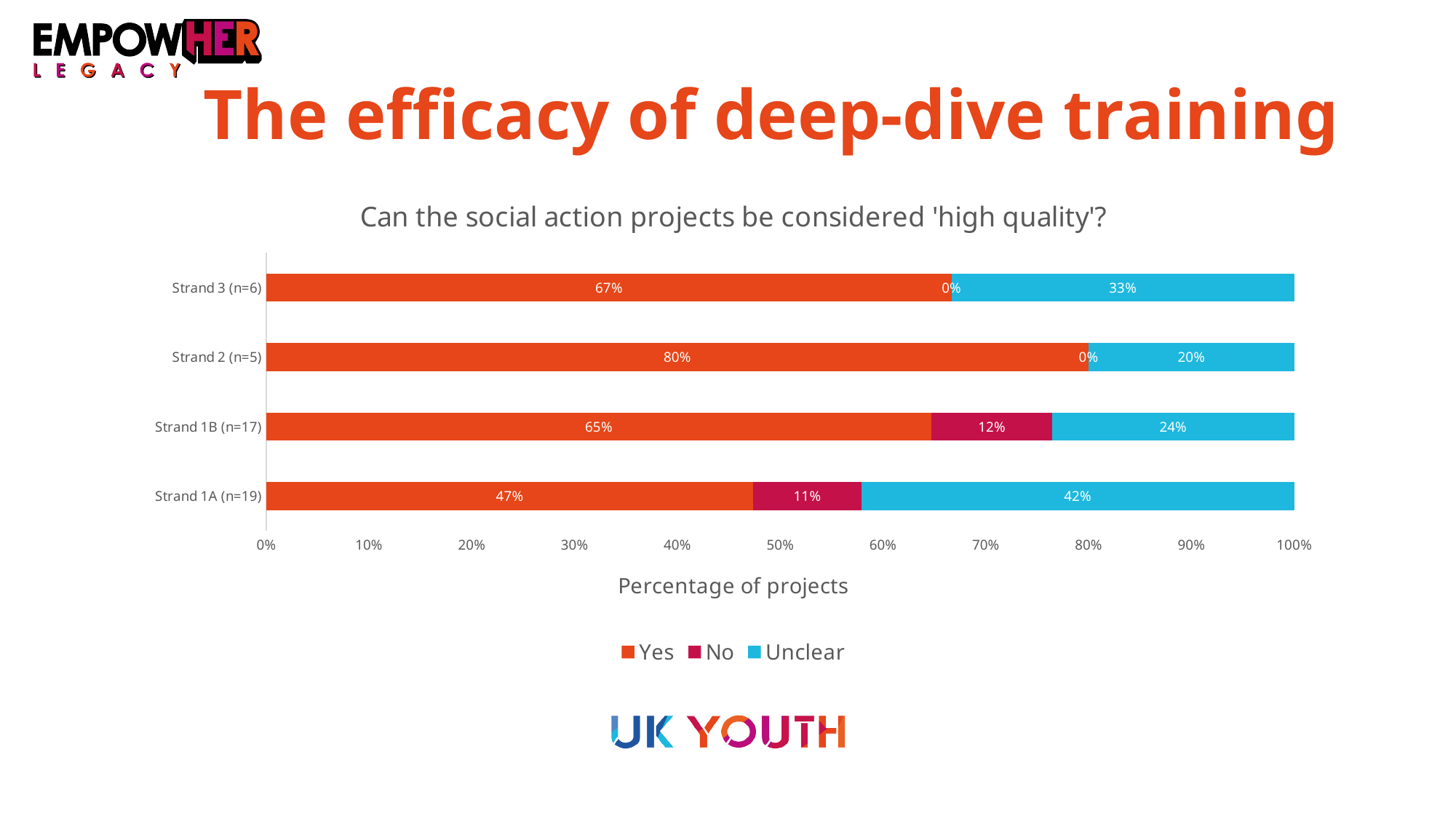
What percentage of Strand 1B (n=17) projects were rated 'No'? 12% Which strand has the lowest 'Yes' percentage? Strand 1A (n=19) What is the difference between the 'Yes' percentages for Strand 2 (n=5) and Strand 1A (n=19)? 33% Which strand has the highest 'Yes' percentage? Strand 2 (n=5) What percentage of Strand 3 (n=6) projects were rated 'Unclear'? 33% What percentage of Strand 2 (n=5) projects were rated 'Yes'? 80% What percentage of Strand 1A (n=19) projects were rated 'Unclear'? 42% Which is larger: the 'Unclear' percentage for Strand 1A (n=19) or for Strand 1B (n=17)? Strand 1A (n=19) How many strands are shown on the chart? 4 What kind of chart is shown on the slide? Stacked bar chart What is the title of the x axis? Percentage of projects How many series does the legend list? 3